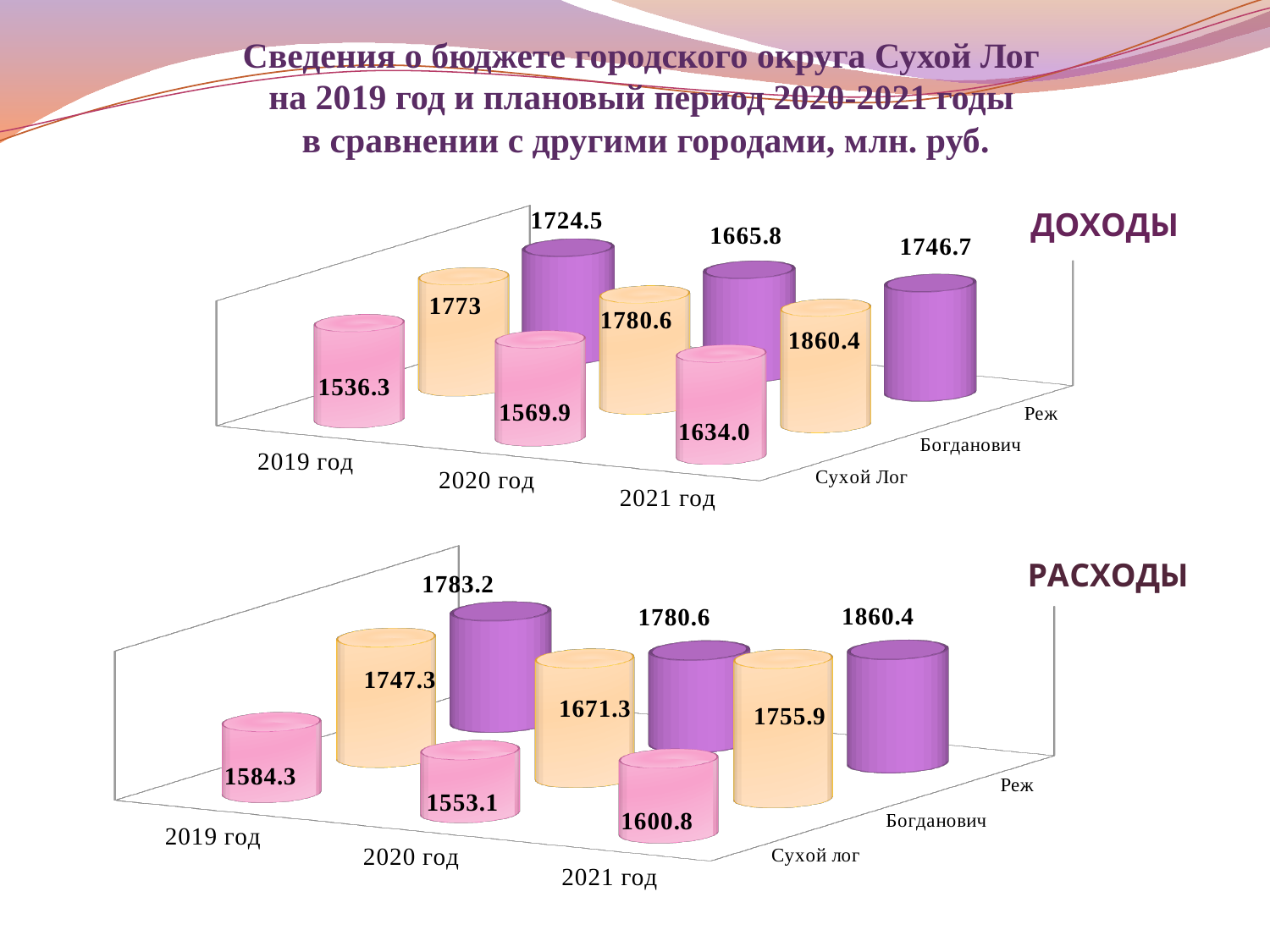
In the ДОХОДЫ chart, what is the value for Реж in 2020 год? 1665.8 How many years are shown on the x axis of the РАСХОДЫ chart? 3 In the РАСХОДЫ chart, what is the value for Сухой лог in 2020 год? 1553.1 In the ДОХОДЫ chart, what is the difference between the values for Богданович and Сухой Лог in 2019 год? 236.7 What kind of chart is the ДОХОДЫ chart? bar chart In the ДОХОДЫ chart, which city has the highest value in 2021 год? Богданович In the РАСХОДЫ chart, which city has the lowest value in 2019 год? Сухой лог In the ДОХОДЫ chart, what is the value for Сухой Лог in 2019 год? 1536.3 In the ДОХОДЫ chart, do the values for Сухой Лог rise or fall from 2019 год to 2021 год? rise In the ДОХОДЫ chart, what is the value for Богданович in 2021 год? 1860.4